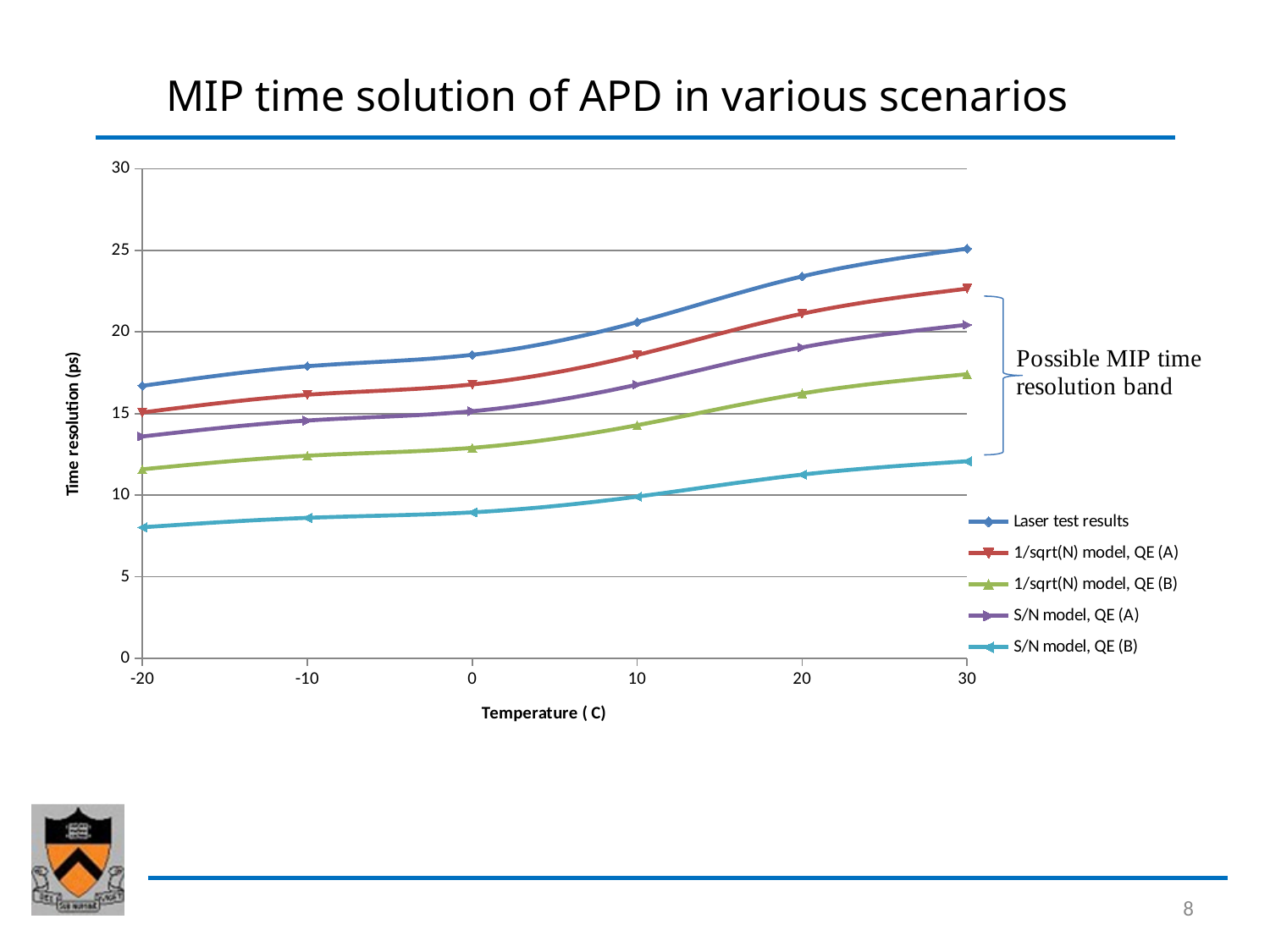
Is the value for 1/sqrt(N) model, QE (A) at 30 C greater or less than 20? greater Which series has the highest time resolution at 30 C? Laser test results How many temperature points are plotted for each series? 6 What kind of chart is shown on the slide? line chart Is the value for Laser test results at 20 C greater or less than 20? greater Which series has the lowest time resolution across the temperature range? S/N model, QE (B) Is the value for 1/sqrt(N) model, QE (B) at 0 C greater or less than 15? less What is the title of the y axis? Time resolution (ps) At 0 C, which is larger: Laser test results or S/N model, QE (B)? Laser test results Do the time resolution values rise or fall as temperature increases from -20 to 30? rise How many series does the legend list? 5